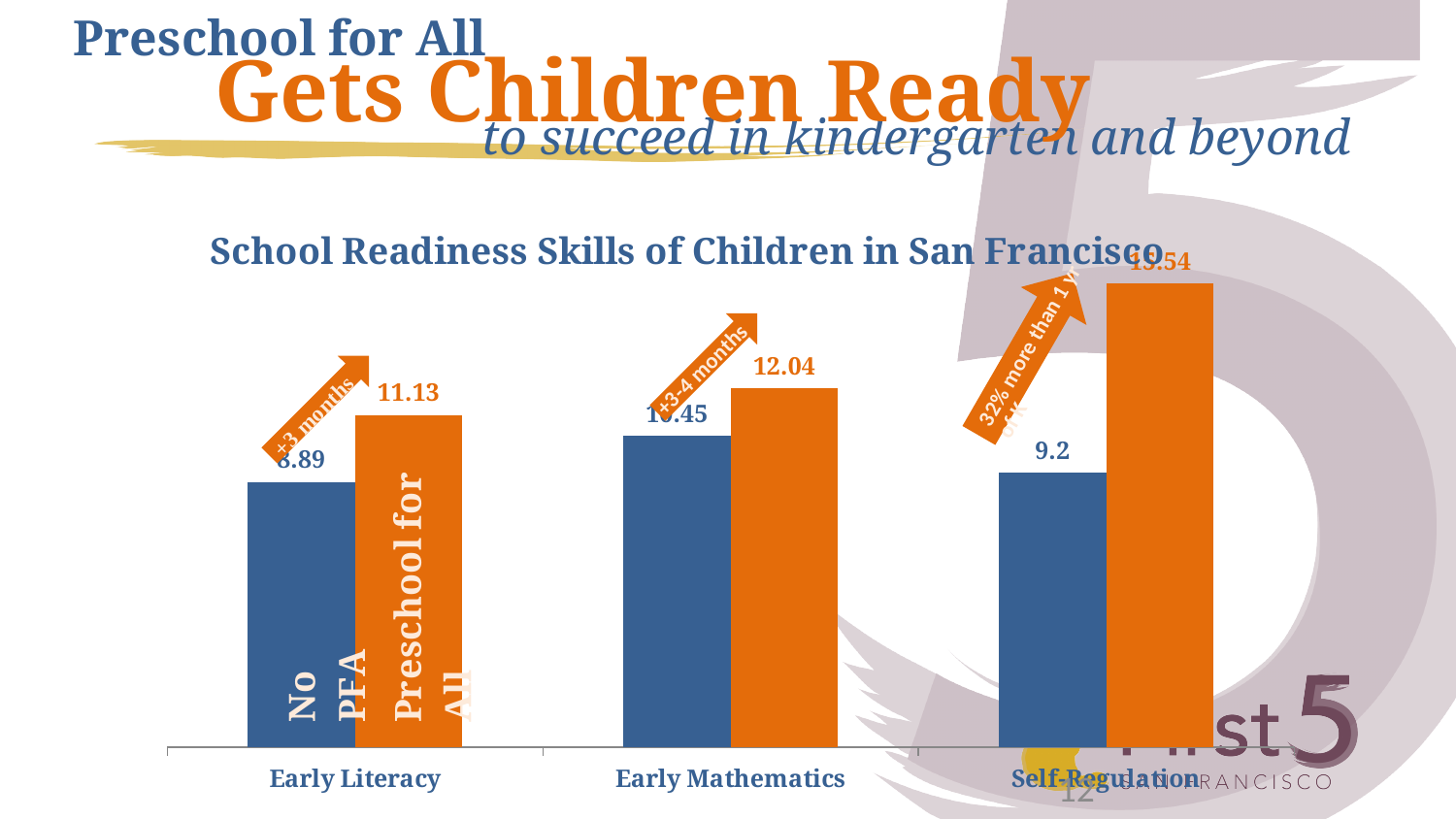
How many categories are shown on the x axis of the chart? 3 Which category has the highest Preschool for All value? Self-Regulation What is the No PFA value for Self-Regulation? 9.2 What is the difference between the Preschool for All and No PFA values for Self-Regulation? 6.34 How many data series does the chart show? 2 What type of chart is shown on the slide? Bar chart What is the title of the chart? School Readiness Skills of Children in San Francisco What is the Preschool for All value for Early Literacy? 11.13 Which category has the lowest Preschool for All value? Early Literacy What is the Preschool for All value for Self-Regulation? 15.54 For Early Mathematics, which is larger: the No PFA value or the Preschool for All value? Preschool for All What is the Preschool for All value for Early Mathematics? 12.04